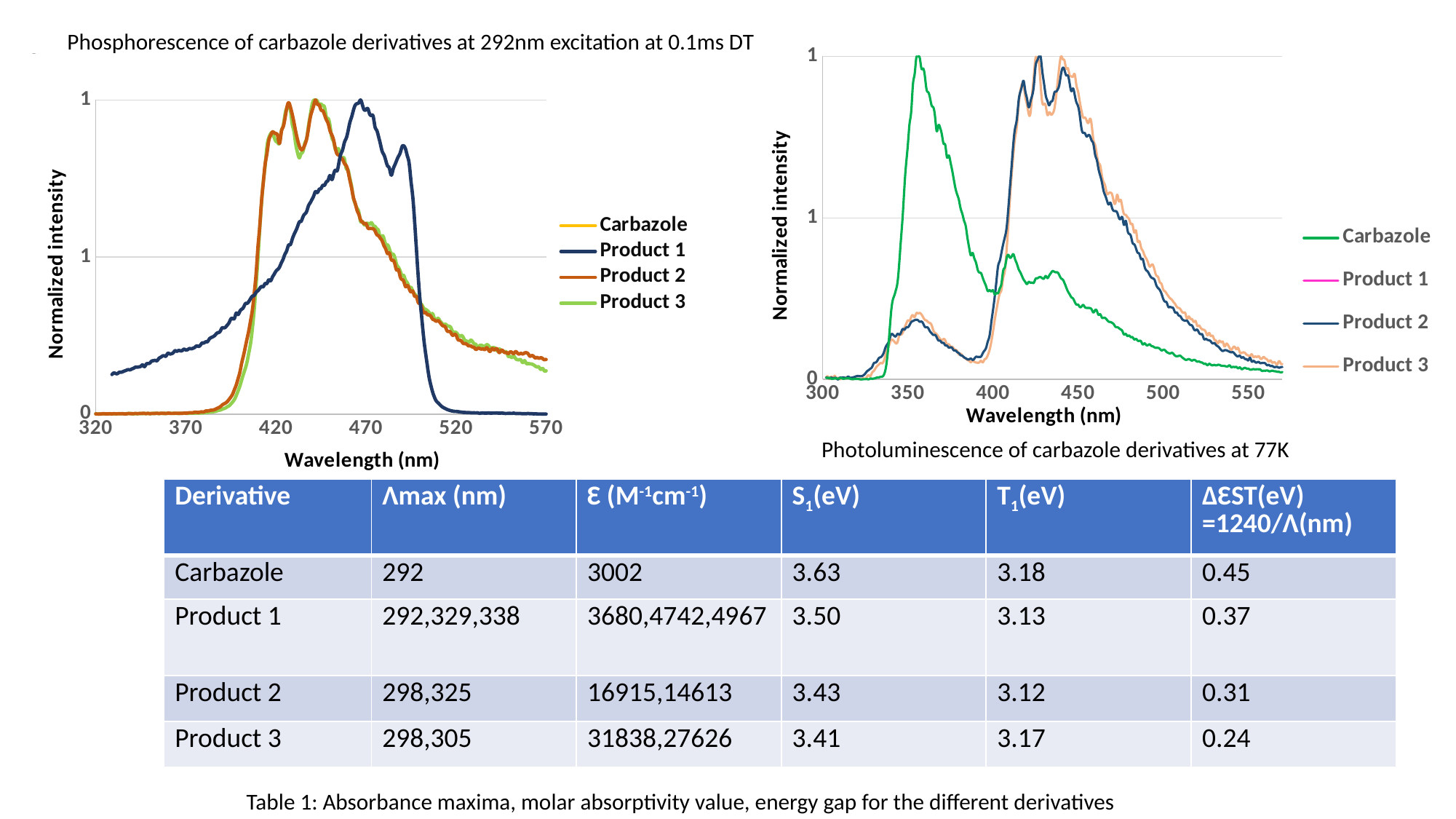
In the 'Phosphorescence of carbazole derivatives at 292nm excitation at 0.1ms DT' chart, which series reaches its peak at the longest wavelength? Product 1 How many labelled tick marks are on the x axis of the 'Photoluminescence of carbazole derivatives at 77K' chart? 6 What is the x-axis label of the 'Phosphorescence of carbazole derivatives at 292nm excitation at 0.1ms DT' chart? Wavelength (nm) How many series does the legend of the 'Photoluminescence of carbazole derivatives at 77K' chart list? 4 In the 'Photoluminescence of carbazole derivatives at 77K' chart, which series reaches its peak at the shortest wavelength? Carbazole In the 'Photoluminescence of carbazole derivatives at 77K' chart, does the Carbazole curve rise or fall between 360 nm and 390 nm? Fall In the 'Photoluminescence of carbazole derivatives at 77K' chart, at 350 nm, which series has the higher normalized intensity, Carbazole or Product 2? Carbazole In the 'Phosphorescence of carbazole derivatives at 292nm excitation at 0.1ms DT' chart, at 470 nm, which series has the higher normalized intensity, Product 1 or Product 2? Product 1 What kind of chart is the 'Phosphorescence of carbazole derivatives at 292nm excitation at 0.1ms DT' chart? Line chart How many series does the legend of the 'Phosphorescence of carbazole derivatives at 292nm excitation at 0.1ms DT' chart list? 4 In the 'Phosphorescence of carbazole derivatives at 292nm excitation at 0.1ms DT' chart, at 370 nm, which series has the higher normalized intensity, Product 1 or Product 3? Product 1 In the 'Phosphorescence of carbazole derivatives at 292nm excitation at 0.1ms DT' chart, does the Product 1 curve rise or fall between 320 nm and 470 nm? Rise